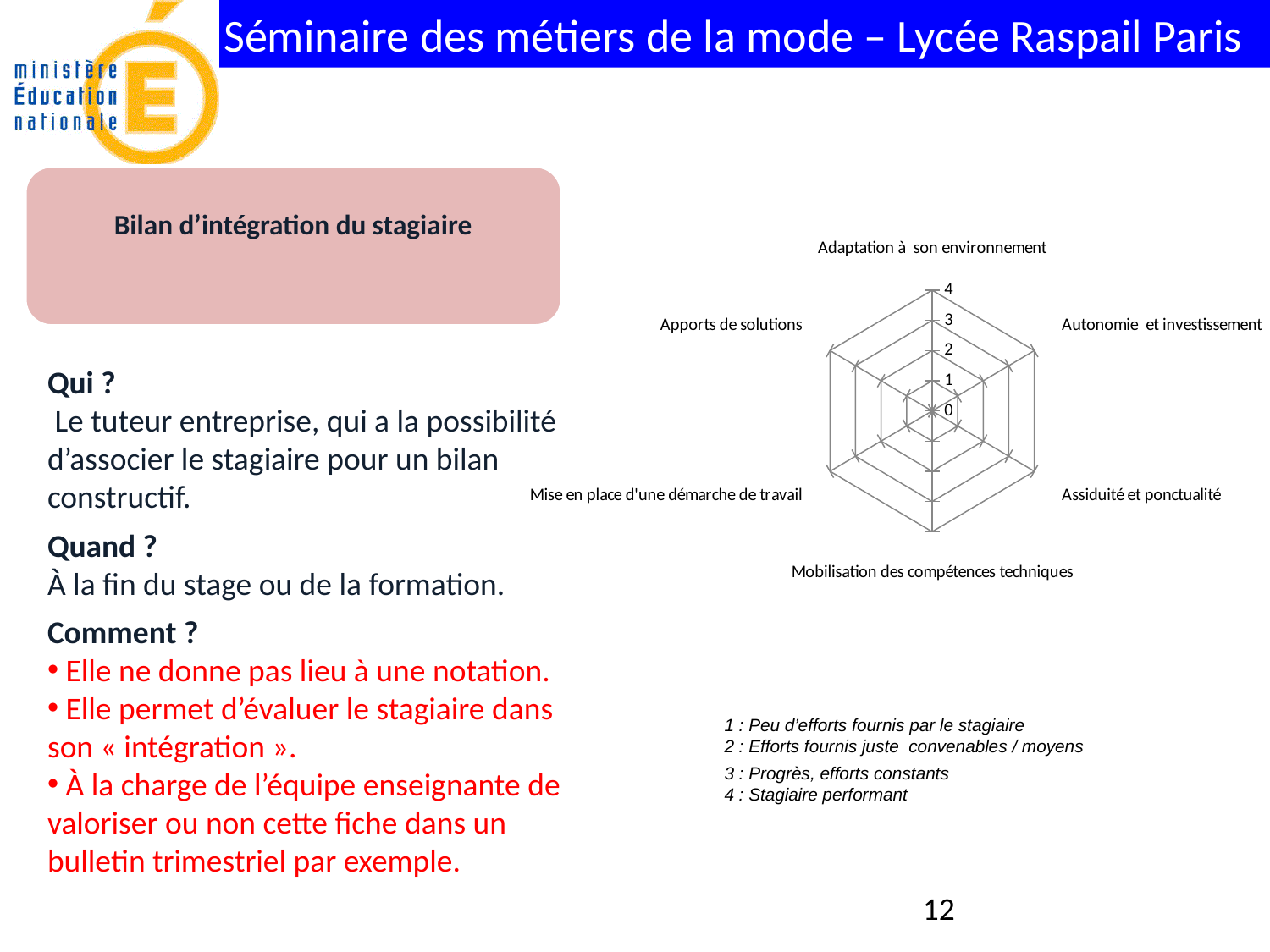
According to the key below the chart, what does a score of 1 mean? Peu d'efforts fournis par le stagiaire Which category label is on the upper right of the radar chart? Autonomie et investissement Which category label appears at the top of the radar chart? Adaptation à son environnement Which category label is on the lower left of the radar chart? Mise en place d'une démarche de travail Which category label is on the upper left of the radar chart? Apports de solutions What is the lowest value shown on the radar chart's scale? 0 How many categories (axes) does the radar chart have? 6 What is the highest value shown on the radar chart's scale? 4 What kind of chart is shown on the slide? Radar chart According to the key below the chart, what does a score of 4 mean? Stagiaire performant Which category label is on the lower right of the radar chart? Assiduité et ponctualité Which category label appears at the bottom of the radar chart? Mobilisation des compétences techniques